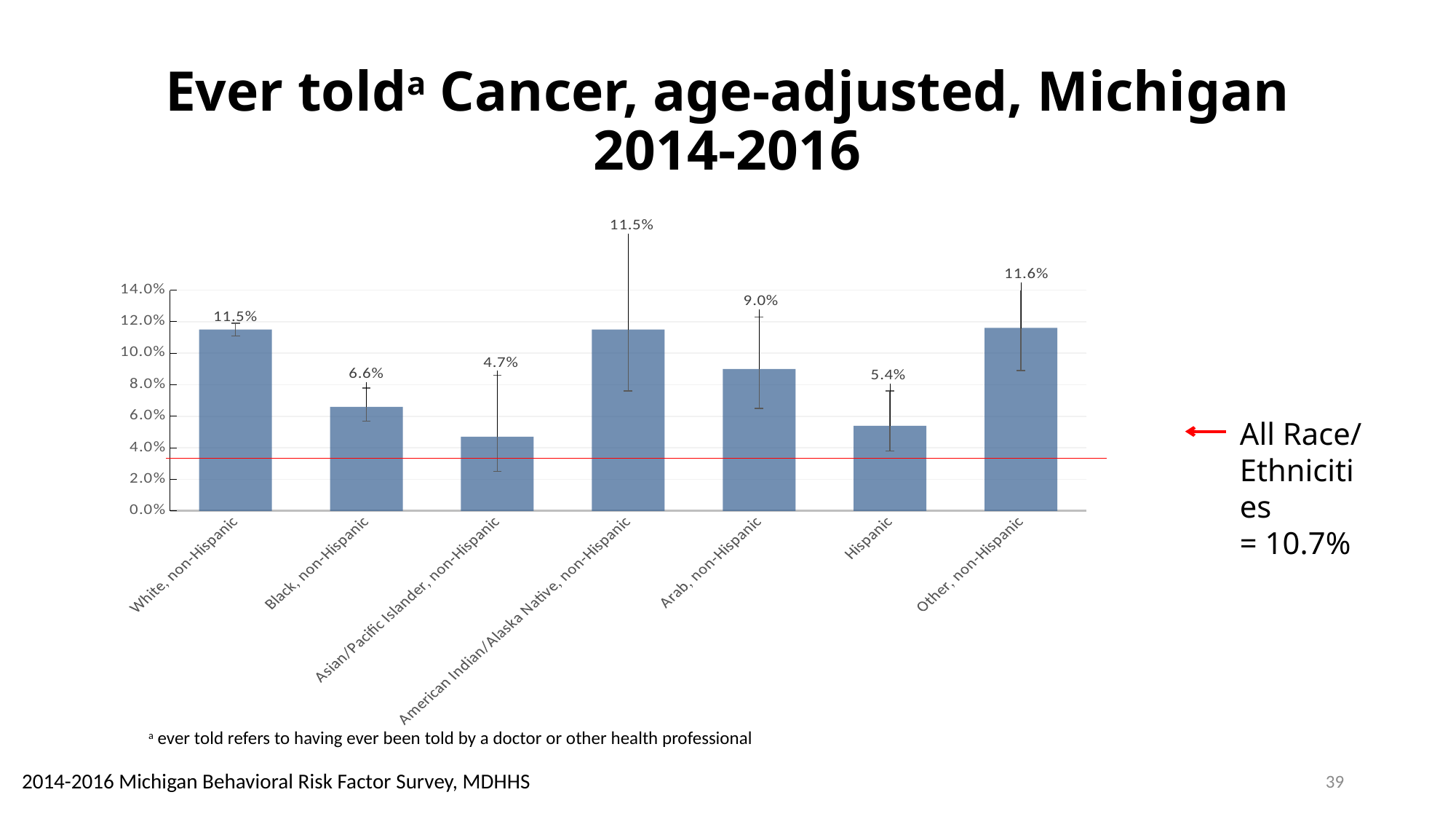
Is the value for Other, non-Hispanic greater or less than 10.0%? greater Which is larger, the value for Arab, non-Hispanic or the value for Hispanic? Arab, non-Hispanic What is the value for White, non-Hispanic? 11.5% Which category has the lowest value? Asian/Pacific Islander, non-Hispanic What kind of chart is shown on the slide? bar chart What is the difference between the values for White, non-Hispanic and Black, non-Hispanic? 4.9% What is the value for Black, non-Hispanic? 6.6% What is the value for All Race/Ethnicities noted beside the chart? 10.7% What is the value for Arab, non-Hispanic? 9.0% What is the value for Hispanic? 5.4% How many race/ethnicity categories are shown on the chart? 7 What is the value for Asian/Pacific Islander, non-Hispanic? 4.7%